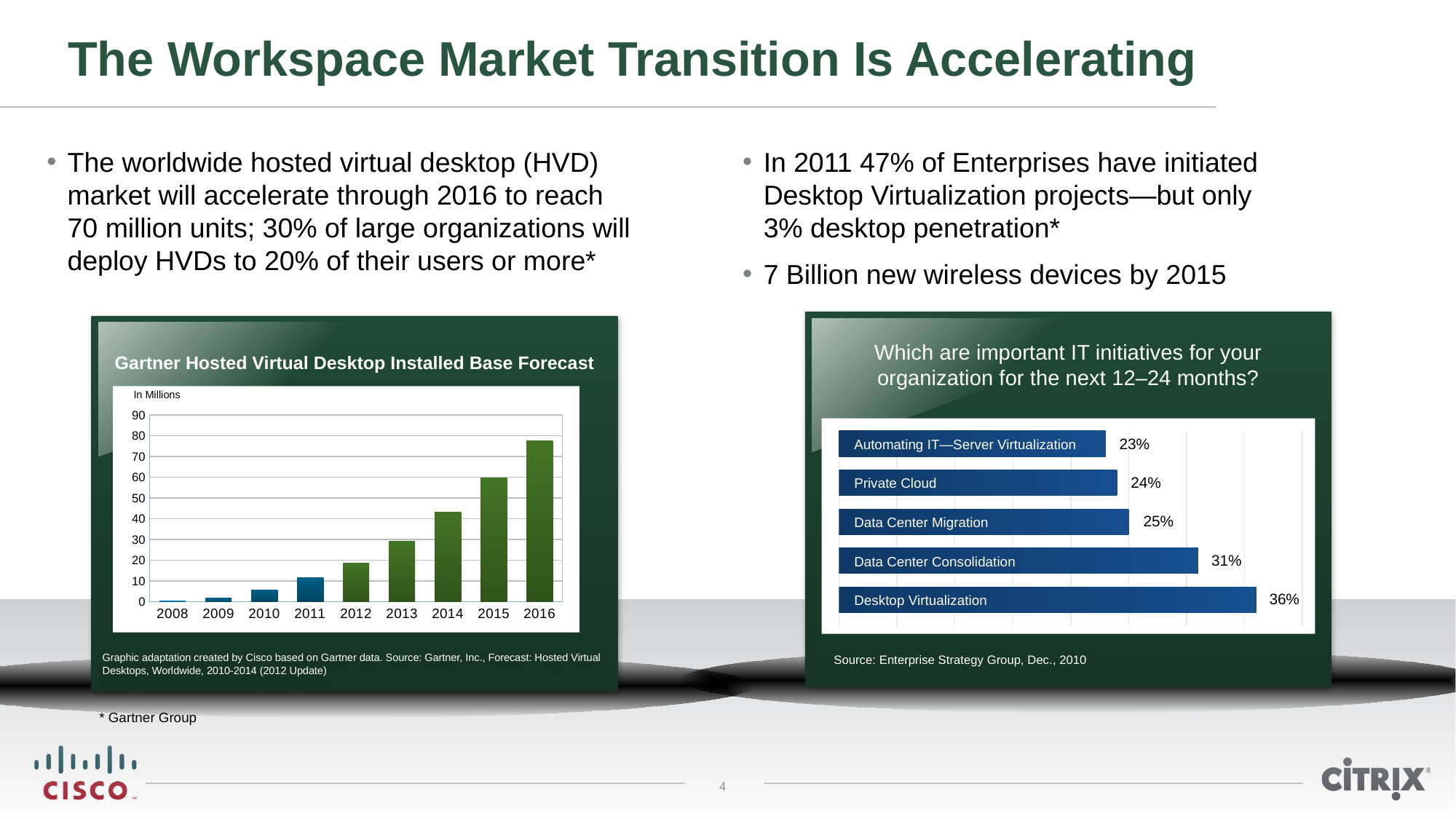
In the chart titled 'Which are important IT initiatives for your organization for the next 12–24 months?', what is the difference between Desktop Virtualization and Data Center Consolidation? 5% In the chart titled 'Which are important IT initiatives for your organization for the next 12–24 months?', which initiative has the lowest value? Automating IT—Server Virtualization In the Gartner Hosted Virtual Desktop Installed Base Forecast chart, is the value for 2016 greater or less than 70? greater How many years are shown on the x axis of the Gartner Hosted Virtual Desktop Installed Base Forecast chart? 9 In the chart titled 'Which are important IT initiatives for your organization for the next 12–24 months?', what is the value for Private Cloud? 24% In the Gartner Hosted Virtual Desktop Installed Base Forecast chart, is the value for 2013 greater or less than 40? less In the Gartner Hosted Virtual Desktop Installed Base Forecast chart, do the values rise or fall from 2008 to 2016? rise In the Gartner Hosted Virtual Desktop Installed Base Forecast chart, which year has the highest value? 2016 In the Gartner Hosted Virtual Desktop Installed Base Forecast chart, which year has the lowest value? 2008 In the chart titled 'Which are important IT initiatives for your organization for the next 12–24 months?', what is the value for Desktop Virtualization? 36% In the Gartner Hosted Virtual Desktop Installed Base Forecast chart, what unit is stated for the values? In Millions What kind of chart is the Gartner Hosted Virtual Desktop Installed Base Forecast chart? bar chart